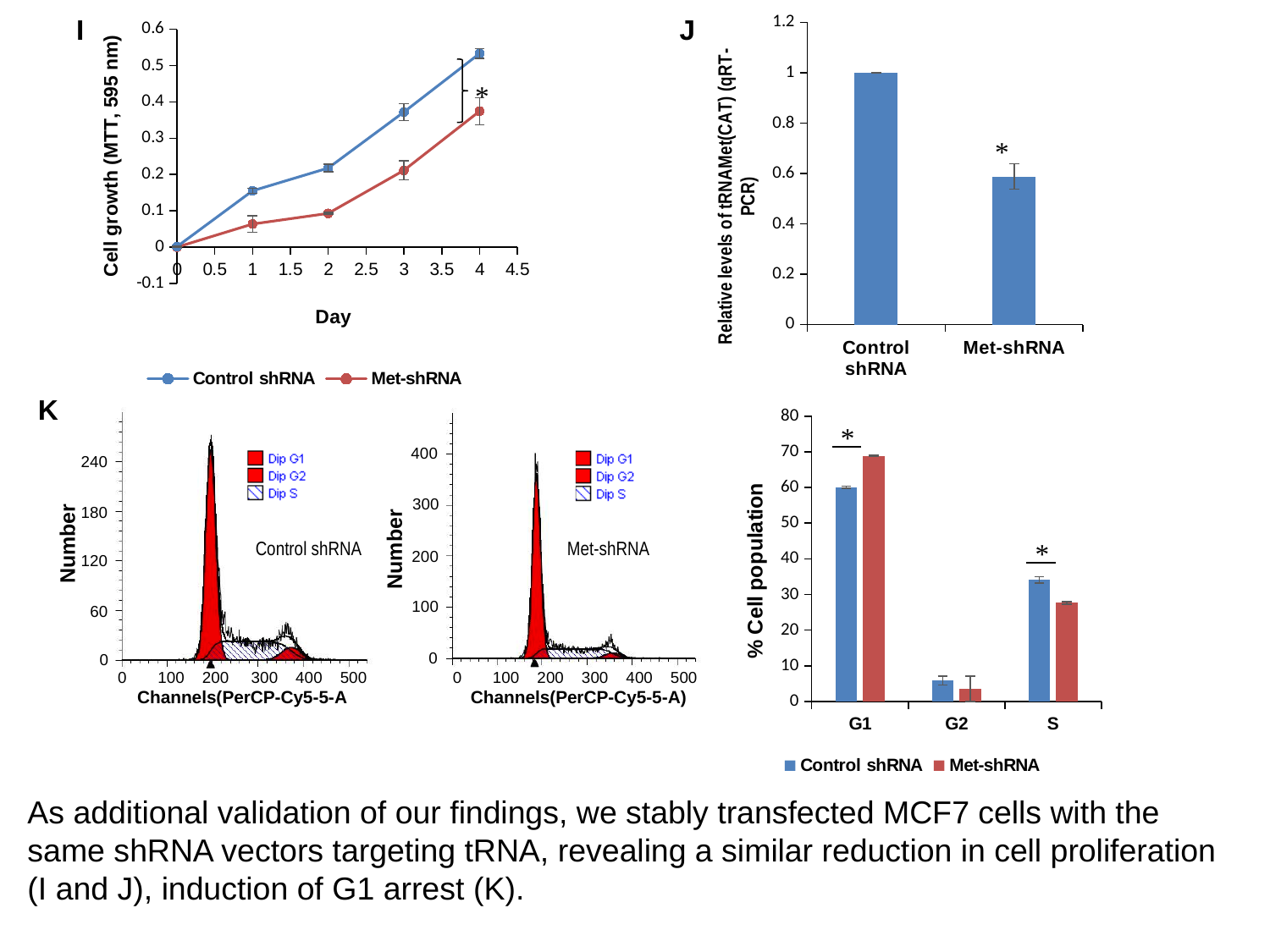
In chart I (Cell growth, MTT), how many series does the legend list? 2 In chart I (Cell growth, MTT), is the Control shRNA value at day 3 greater or less than 0.3? greater In chart I (Cell growth, MTT), which series has the higher value at day 4, Control shRNA or Met-shRNA? Control shRNA What kind of chart is chart I (Cell growth, MTT)? line chart In chart I (Cell growth, MTT), do the Control shRNA values rise or fall from day 0 to day 4? rise In chart I (Cell growth, MTT), is the Met-shRNA value at day 1 greater or less than 0.1? less In the % Cell population bar chart in panel K, is the Control shRNA value for G2 greater or less than 10? less In the % Cell population bar chart in panel K, how many categories are shown on the x axis? 3 In chart J (Relative levels of tRNAMet), which category has the highest value? Control shRNA In chart J (Relative levels of tRNAMet), what is the value for Control shRNA? 1 In the % Cell population bar chart in panel K, which series has the higher value for G1, Control shRNA or Met-shRNA? Met-shRNA